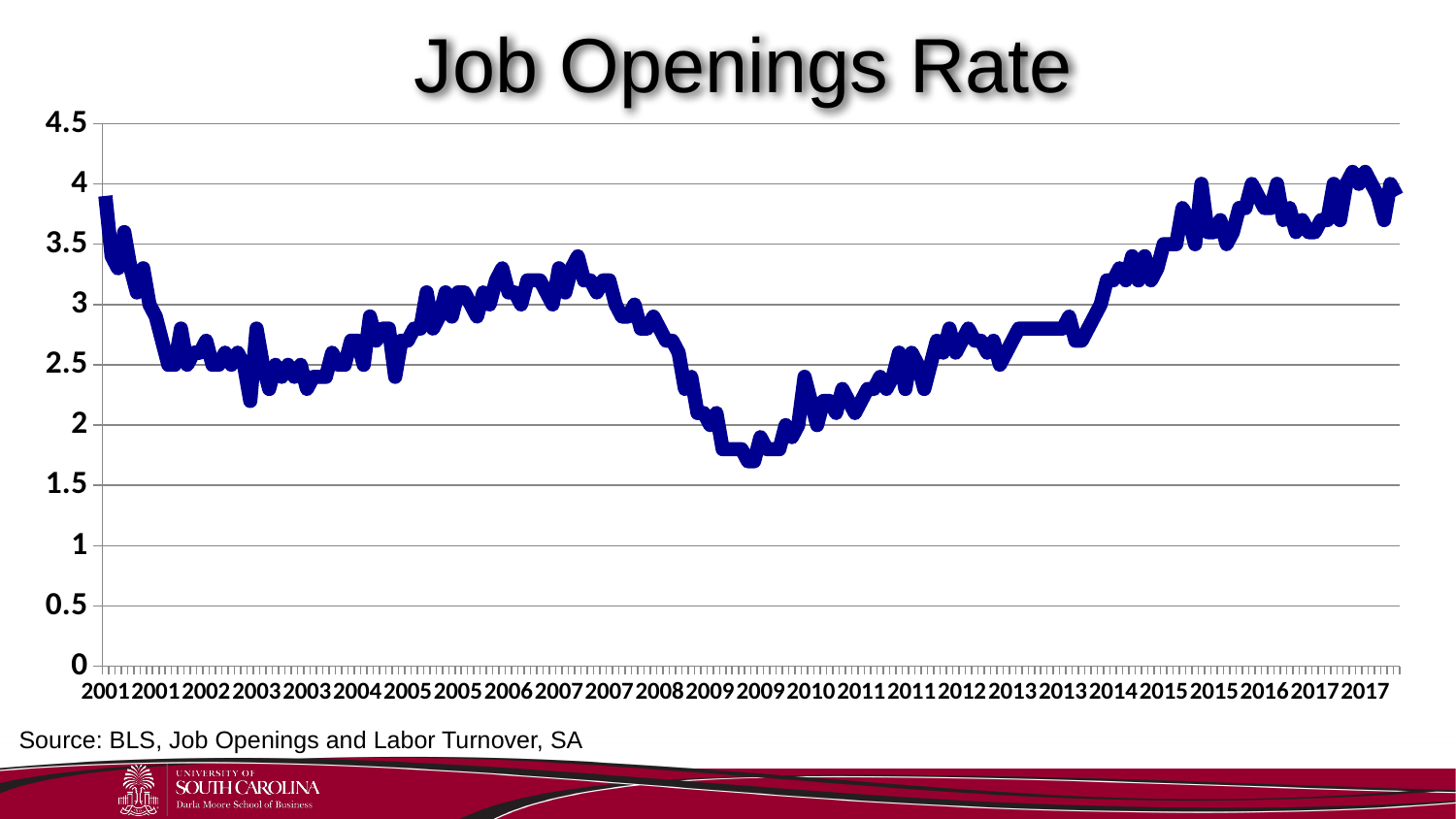
What is the title of the chart? Job Openings Rate How many data series are plotted on the chart? 1 Does the job openings rate rise or fall between 2007 and 2009? Fall What is the highest value shown on the y axis? 4.5 What kind of chart is shown on the slide? Line chart Is the job openings rate in 2017 greater or less than 3.5? greater Which is higher, the job openings rate in 2009 or in 2017? 2017 Is the lowest value of the job openings rate, in 2009, greater or less than 2? less Is the job openings rate in 2003 greater or less than 3? less In which year does the job openings rate reach its lowest point? 2009 Does the job openings rate rise or fall between 2009 and 2017? Rise